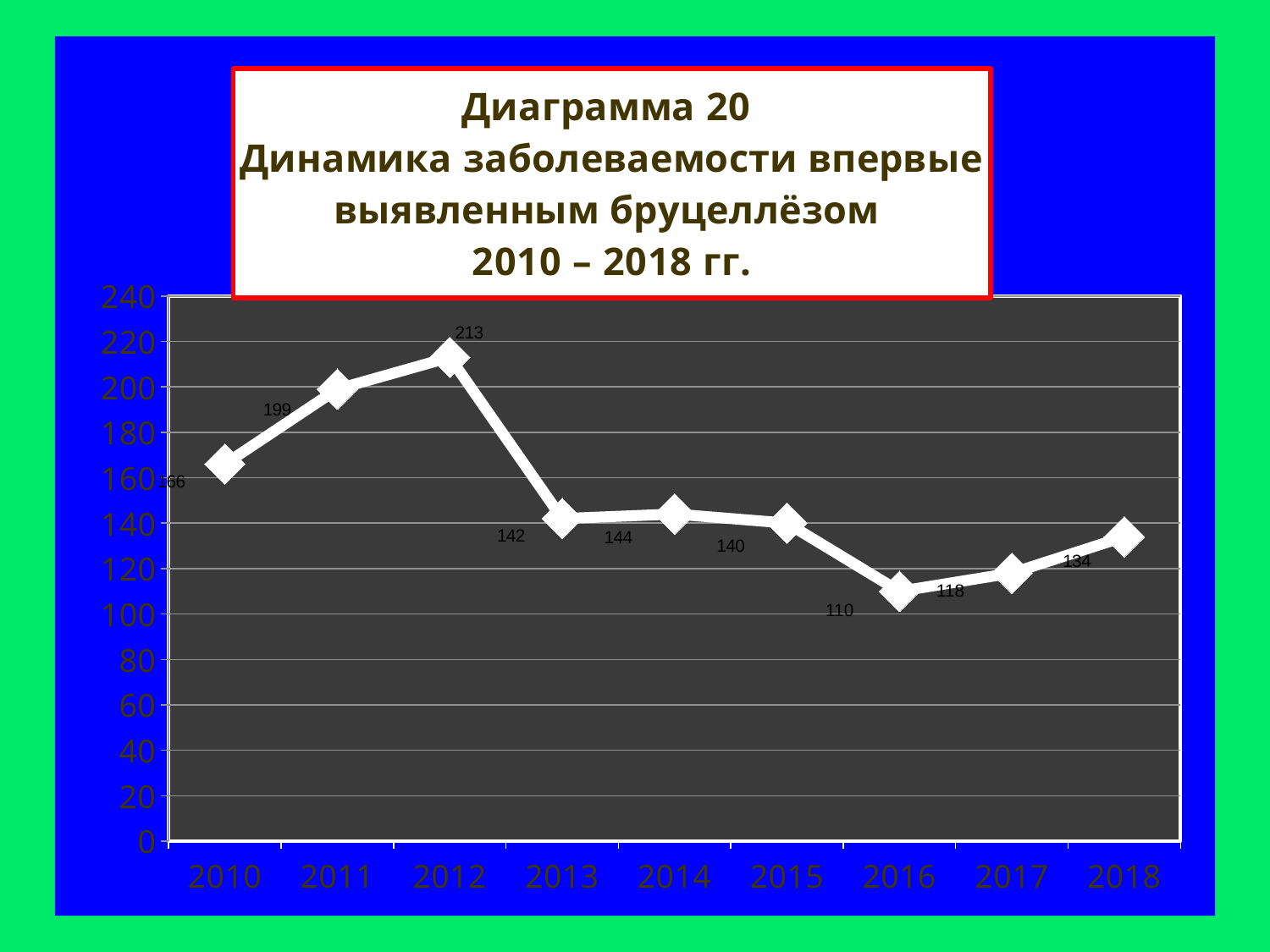
What is the difference between the values for 2012 and 2013? 71 What is the value for 2016? 110 What type of chart is shown on the slide? line chart What is the value for 2018? 134 How many years are plotted on the x axis? 9 Which is larger, the value for 2011 or the value for 2017? 2011 What is the number of the diagram given in the chart title? Диаграмма 20 What is the value for 2010? 166 Do the values rise or fall from 2016 to 2018? rise Which year has the highest value? 2012 Which year has the lowest value? 2016 What is the value for 2012? 213